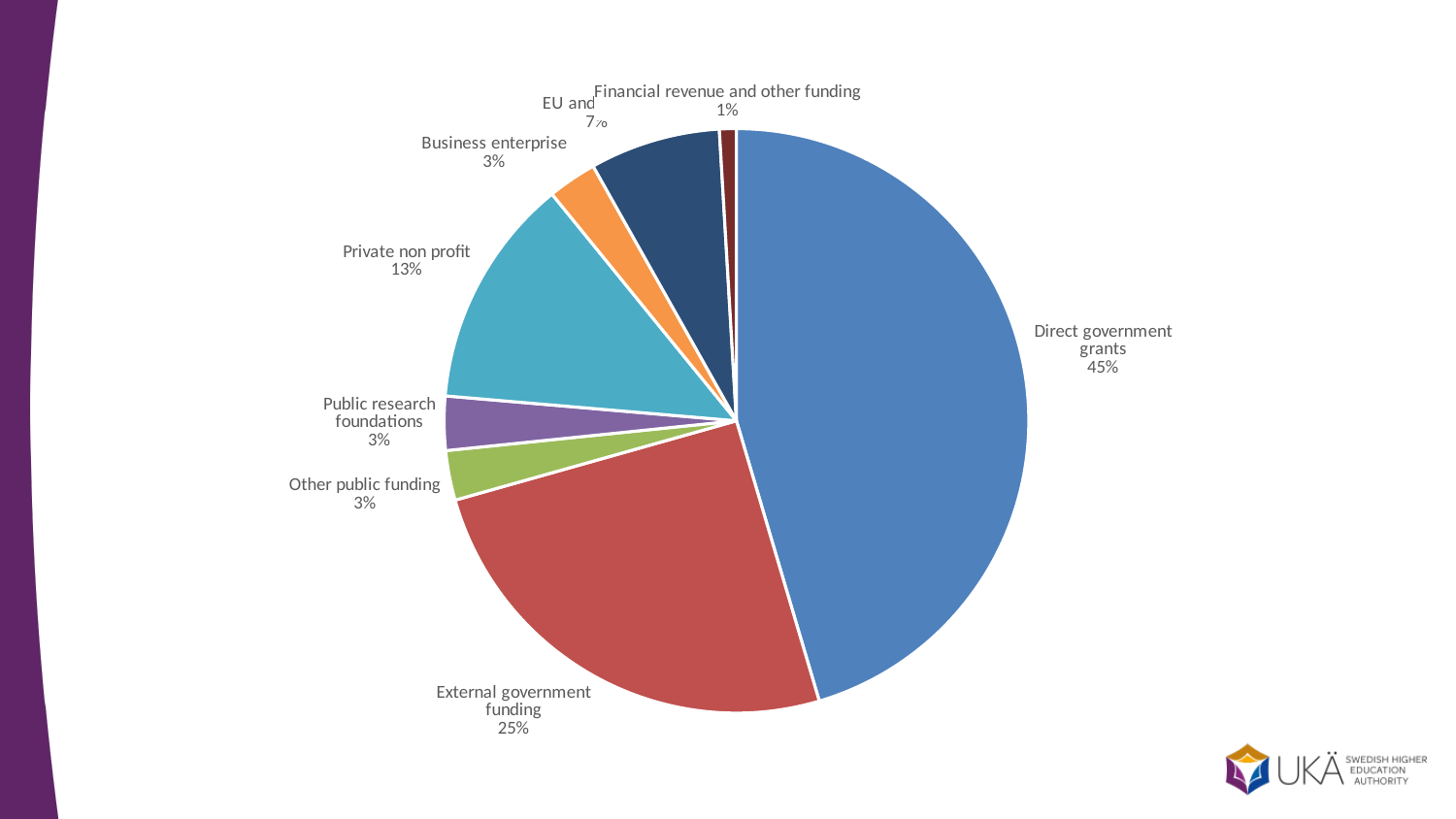
Which category has the smallest share of the pie? Financial revenue and other funding What is the difference in percentage points between Direct government grants and External government funding? 20 What share of the pie is Business enterprise? 3% What share of the pie is External government funding? 25% What share of the pie is Private non profit? 13% What share of the pie is Direct government grants? 45% What kind of chart is shown on the slide? pie chart Which category has the largest share of the pie? Direct government grants What share of the pie is Financial revenue and other funding? 1% How many slices does the pie chart have? 8 What is the combined share of Direct government grants and External government funding? 70% Which is larger, Private non profit or Public research foundations? Private non profit